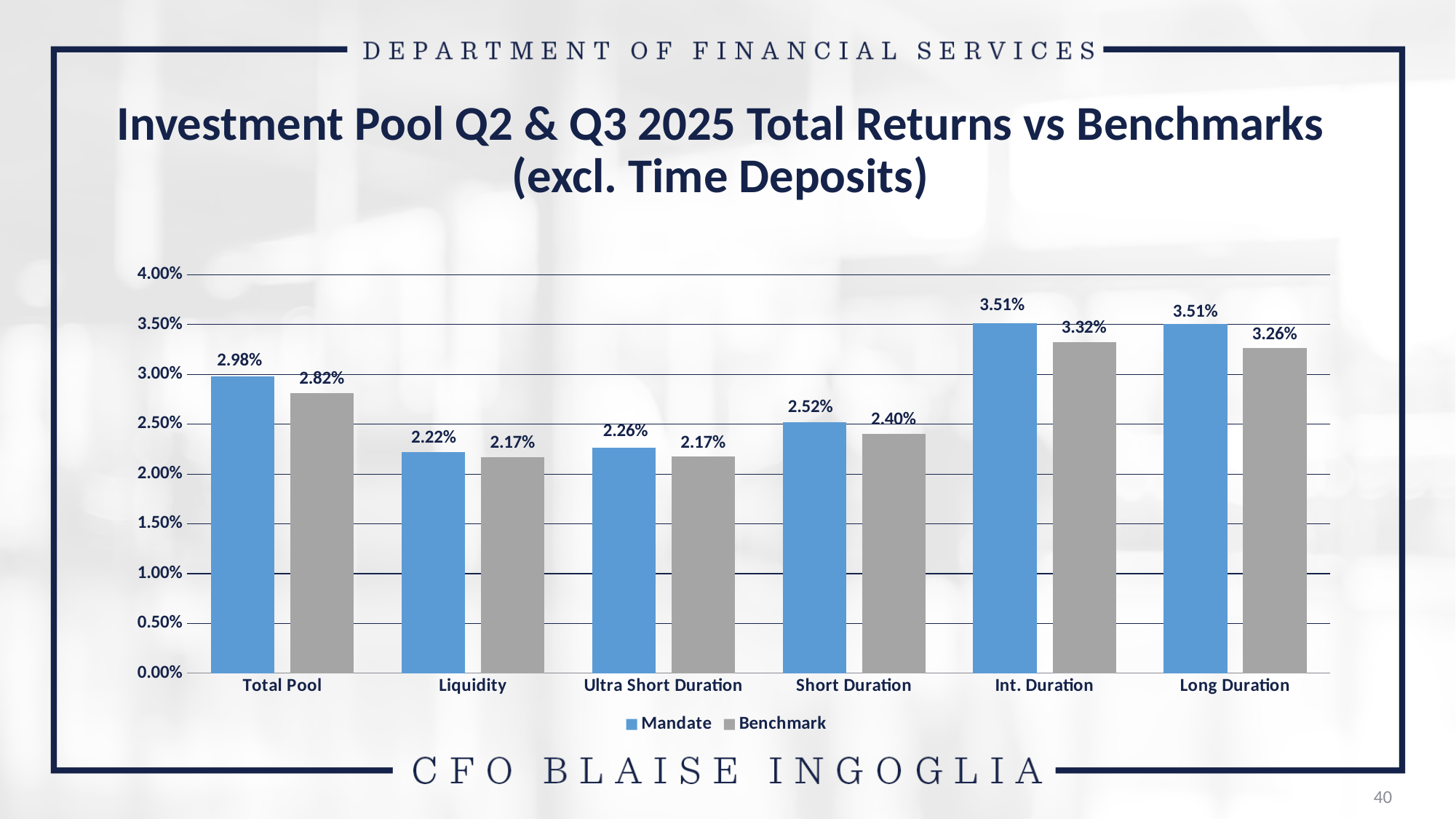
What is the Mandate return for Ultra Short Duration? 2.26% How many series does the legend list? 2 What is the difference between the Mandate and Benchmark returns for Total Pool? 0.16% What is the Benchmark return for Short Duration? 2.40% Which category has the highest Benchmark return? Int. Duration Which category has the lowest Mandate return? Liquidity Which is larger for Liquidity, the Mandate return or the Benchmark return? Mandate How many categories are shown on the x axis? 6 What is the Benchmark return for Long Duration? 3.26% What is the difference between the Mandate and Benchmark returns for Int. Duration? 0.19% What type of chart is shown on the slide? Bar chart What is the Mandate return for Total Pool? 2.98%